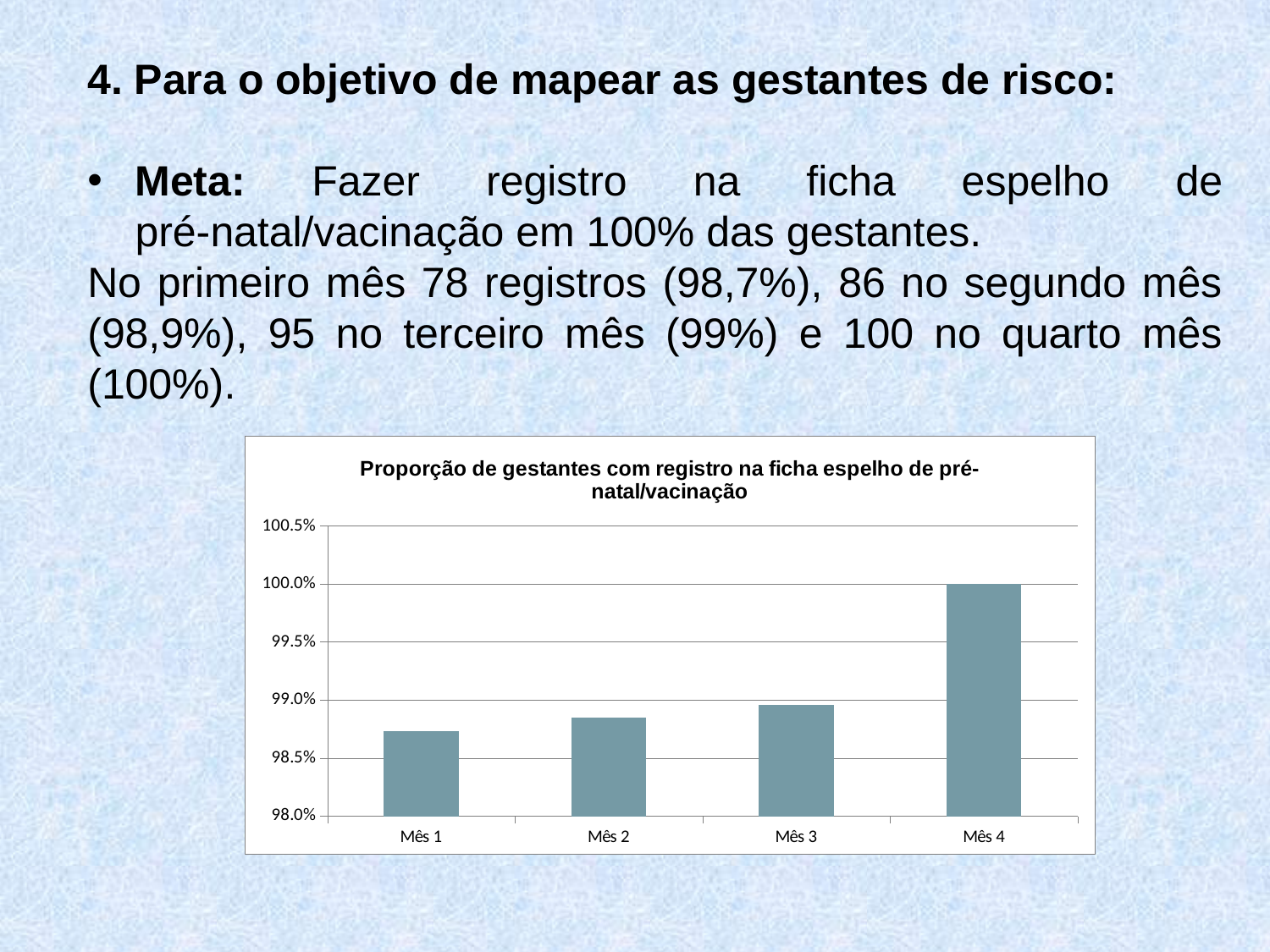
Is the value for Mês 1 greater or less than 99.0%? less Which month has the highest value in the chart? Mês 4 Is the value for Mês 1 greater or less than 98.5%? greater Is the value for Mês 4 greater or less than 99.5%? greater How many categories are shown on the x axis of the chart? 4 What kind of chart is shown on the slide? bar chart Which is larger, the value for Mês 1 or the value for Mês 4? Mês 4 What is the title of the chart? Proporção de gestantes com registro na ficha espelho de pré-natal/vacinação What is the value for Mês 4 in the chart? 100.0% Which month has the lowest value in the chart? Mês 1 Do the values rise or fall from Mês 1 to Mês 4? rise